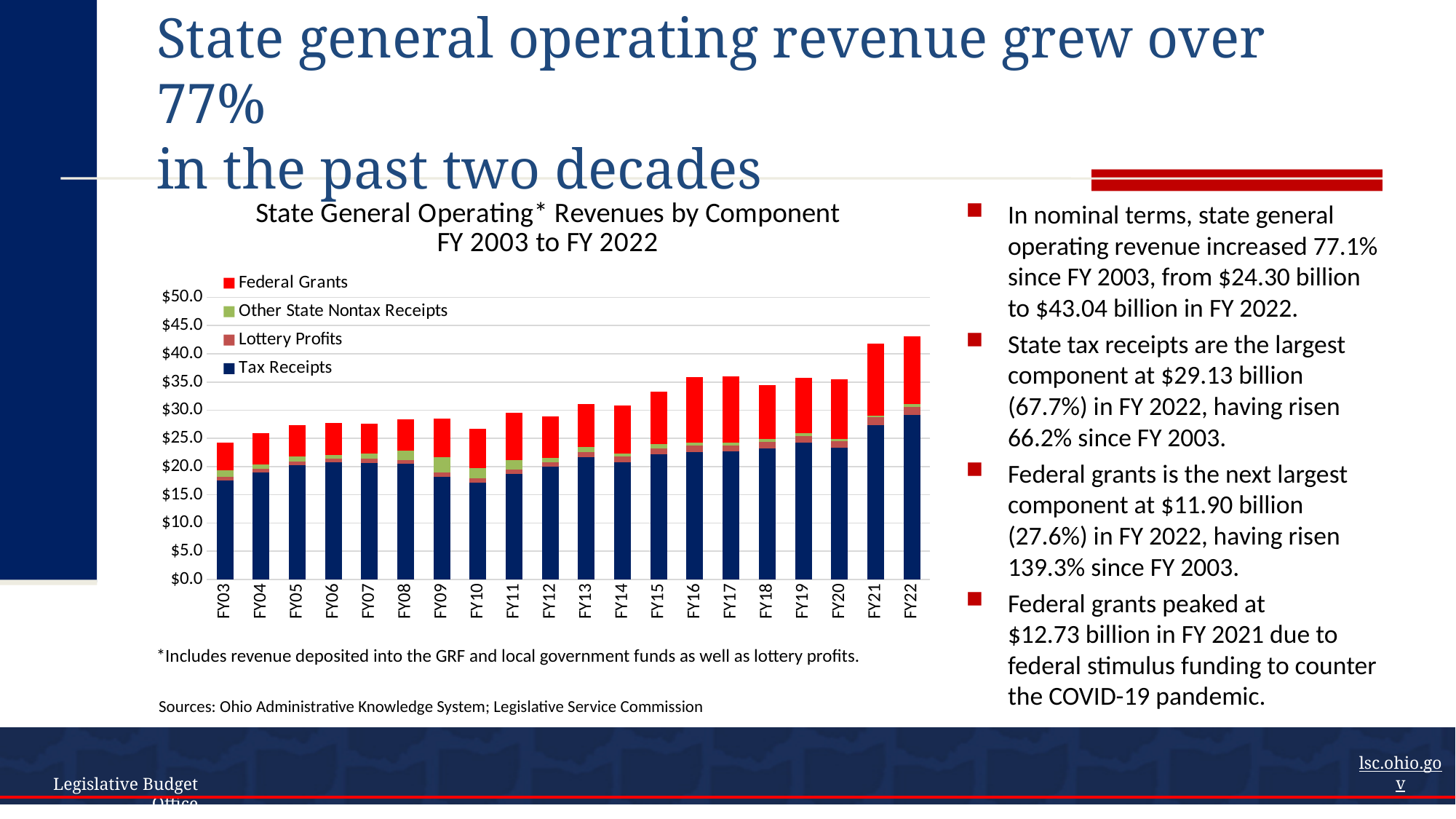
Which fiscal year has the lowest total state general operating revenue? FY03 Is the Tax Receipts segment for FY03 greater or less than $20.0? less What kind of chart is shown on the slide? Stacked bar chart Which has the larger total revenue bar, FY09 or FY10? FY09 Is the total revenue bar for FY22 greater or less than $40.0? greater Is the total revenue bar for FY15 greater or less than $35.0? less Do total state general operating revenues generally rise or fall from FY03 to FY22? rise Which colour represents Federal Grants in the chart's legend? Red How many fiscal years (bars) are plotted in the chart? 20 Which fiscal year has the highest total state general operating revenue? FY22 How many series does the chart's legend list? 4